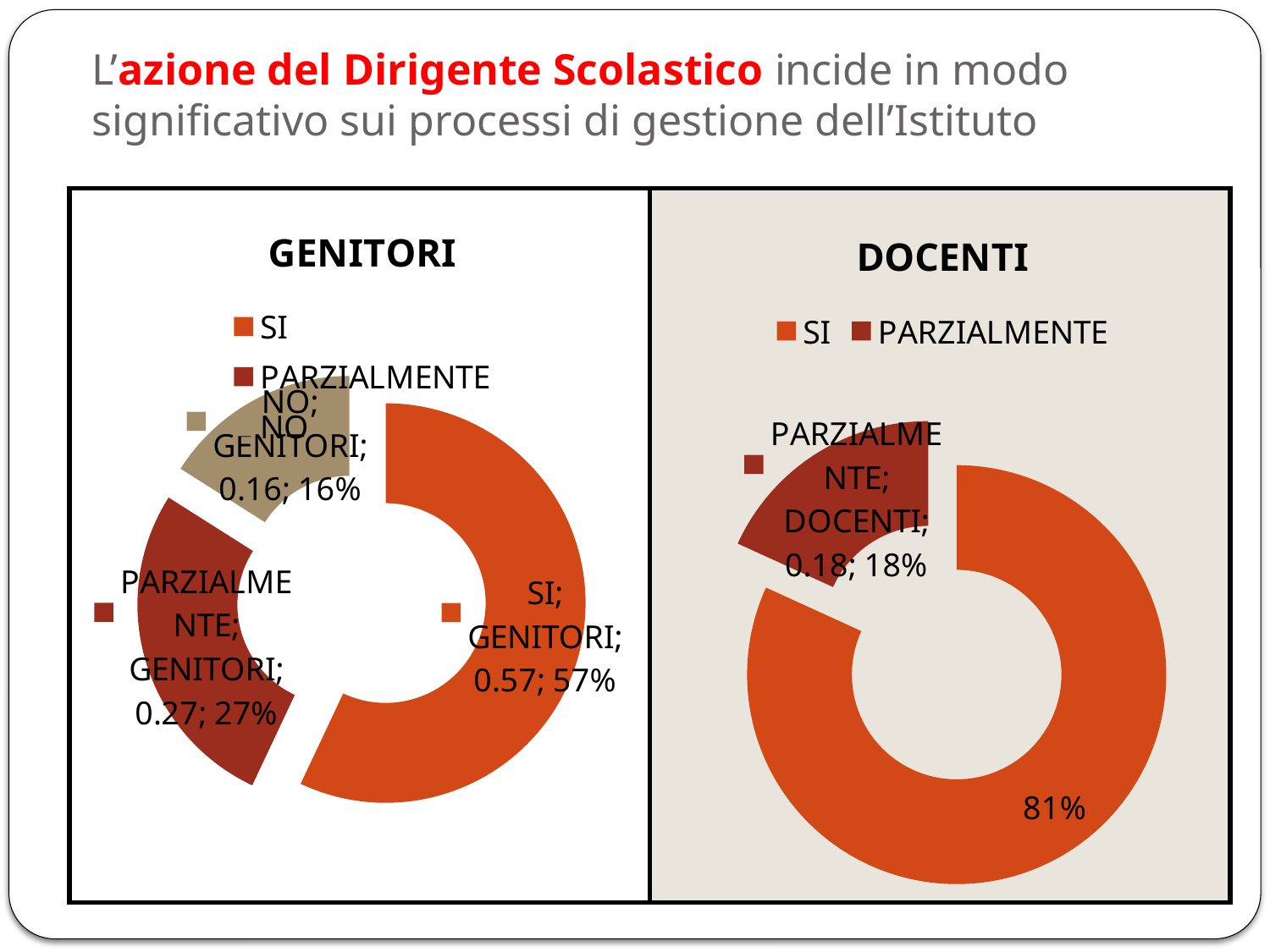
How many slices does the DOCENTI chart have? 2 In the GENITORI chart, what percentage is shown for PARZIALMENTE? 27% In the DOCENTI chart, what percentage is shown for PARZIALMENTE? 18% In the DOCENTI chart, what percentage is shown for SI? 81% In the GENITORI chart, what percentage is shown for SI? 57% In the GENITORI chart, which category has the largest share? SI In the GENITORI chart, which category has the smallest share? NO What kind of chart is the GENITORI chart? Doughnut (pie) chart In the DOCENTI chart, which category has the smallest share? PARZIALMENTE What is the difference in percentage points between SI and PARZIALMENTE in the GENITORI chart? 30 Which is larger: the SI share in the DOCENTI chart or the SI share in the GENITORI chart? DOCENTI In the GENITORI chart, what percentage is shown for NO? 16%